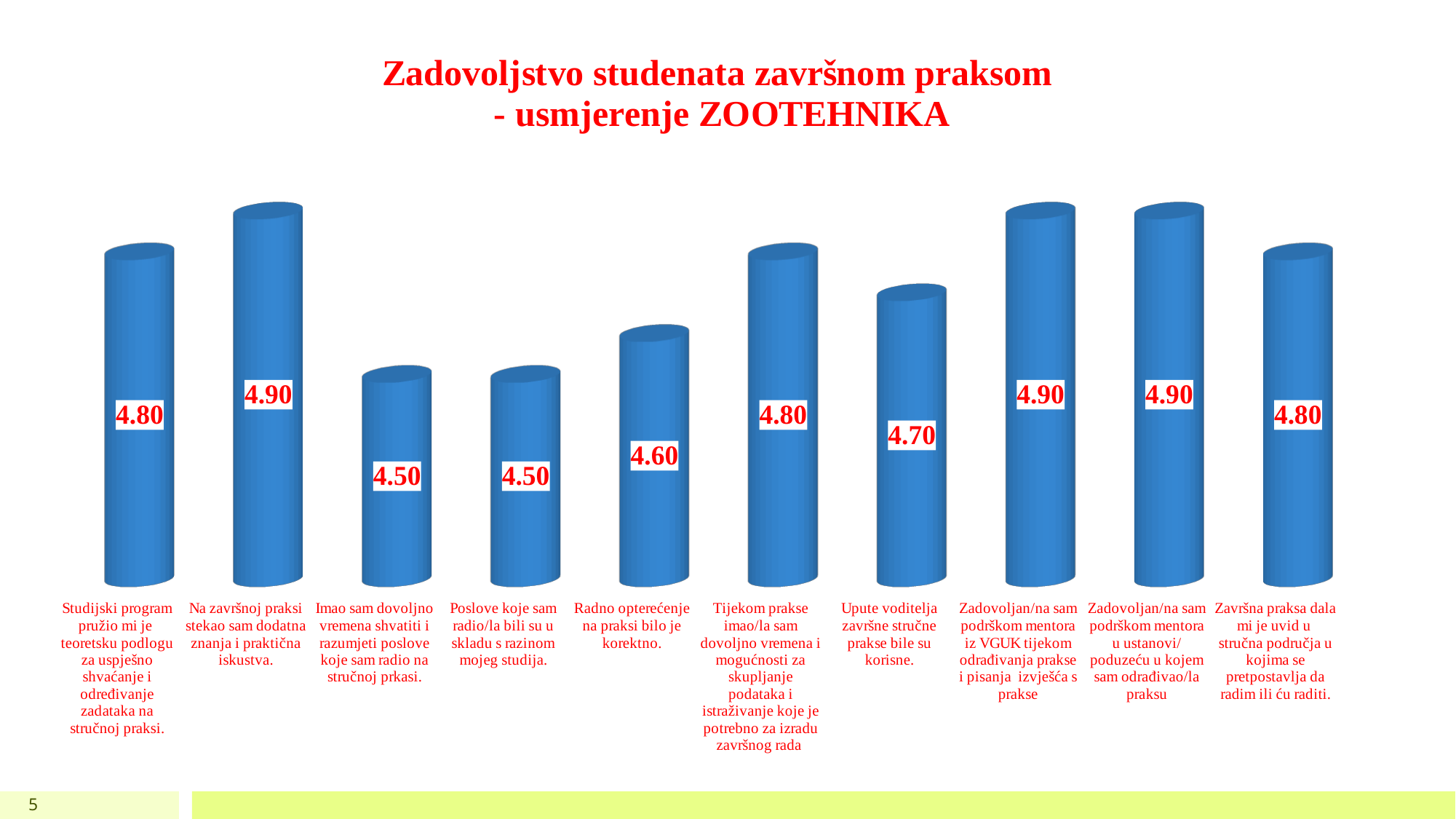
How many categories (bars) are shown in the chart? 10 What kind of chart is shown on the slide? Bar chart What is the lowest value shown in the chart? 4.50 What is the value for "Upute voditelja završne stručne prakse bile su korisne."? 4.70 What is the value for "Na završnoj praksi stekao sam dodatna znanja i praktična iskustva."? 4.90 What is the value for "Poslove koje sam radio/la bili su u skladu s razinom mojeg studija."? 4.50 What is the value for "Završna praksa dala mi je uvid u stručna područja u kojima se pretpostavlja da radim ili ću raditi."? 4.80 What is the highest value shown in the chart? 4.90 What is the difference between the value for "Upute voditelja završne stručne prakse bile su korisne." and the value for "Radno opterećenje na praksi bilo je korektno."? 0.10 Which has a larger value: "Studijski program pružio mi je teoretsku podlogu za uspješno shvaćanje i određivanje zadataka na stručnoj praksi." or "Imao sam dovoljno vremena shvatiti i razumjeti poslove koje sam radio na stručnoj prkasi."? Studijski program pružio mi je teoretsku podlogu za uspješno shvaćanje i određivanje zadataka na stručnoj praksi. What is the title of the chart? Zadovoljstvo studenata završnom praksom - usmjerenje ZOOTEHNIKA What is the value for "Radno opterećenje na praksi bilo je korektno."? 4.60